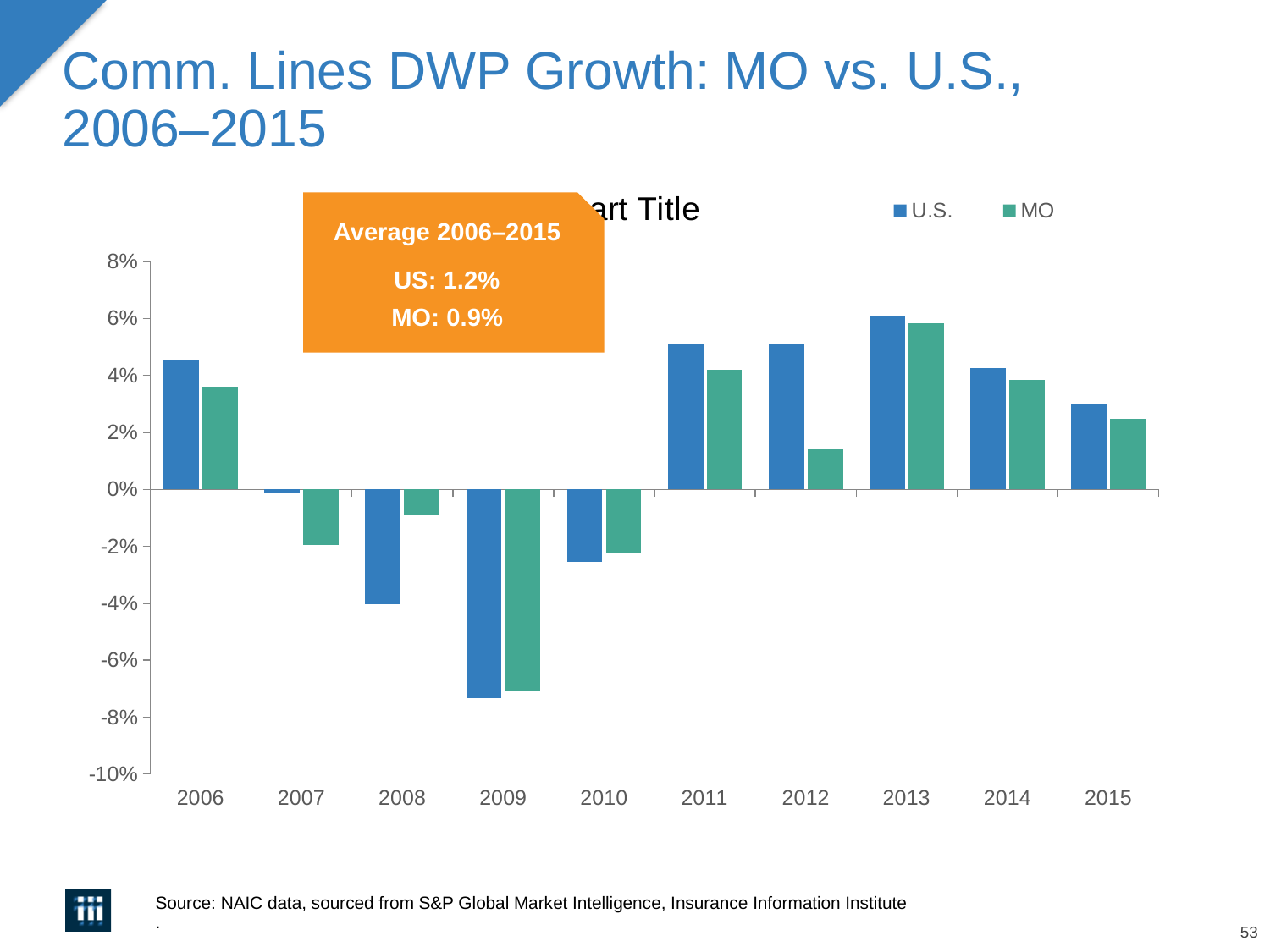
In 2012, which is higher, the U.S. value or the MO value? U.S. Is the MO value for 2012 greater or less than 2%? less What type of chart is shown on the slide? bar chart Is the U.S. value for 2008 greater or less than -2%? less According to the orange box, what is the average 2006–2015 growth for the US? 1.2% Do the U.S. values rise or fall from 2013 to 2015? fall In which year is the U.S. value highest? 2013 In which year is the U.S. value lowest? 2009 In which year is the MO value highest? 2013 In which year is the MO value lowest? 2009 How many series does the legend list? 2 How many years are shown on the x axis? 10